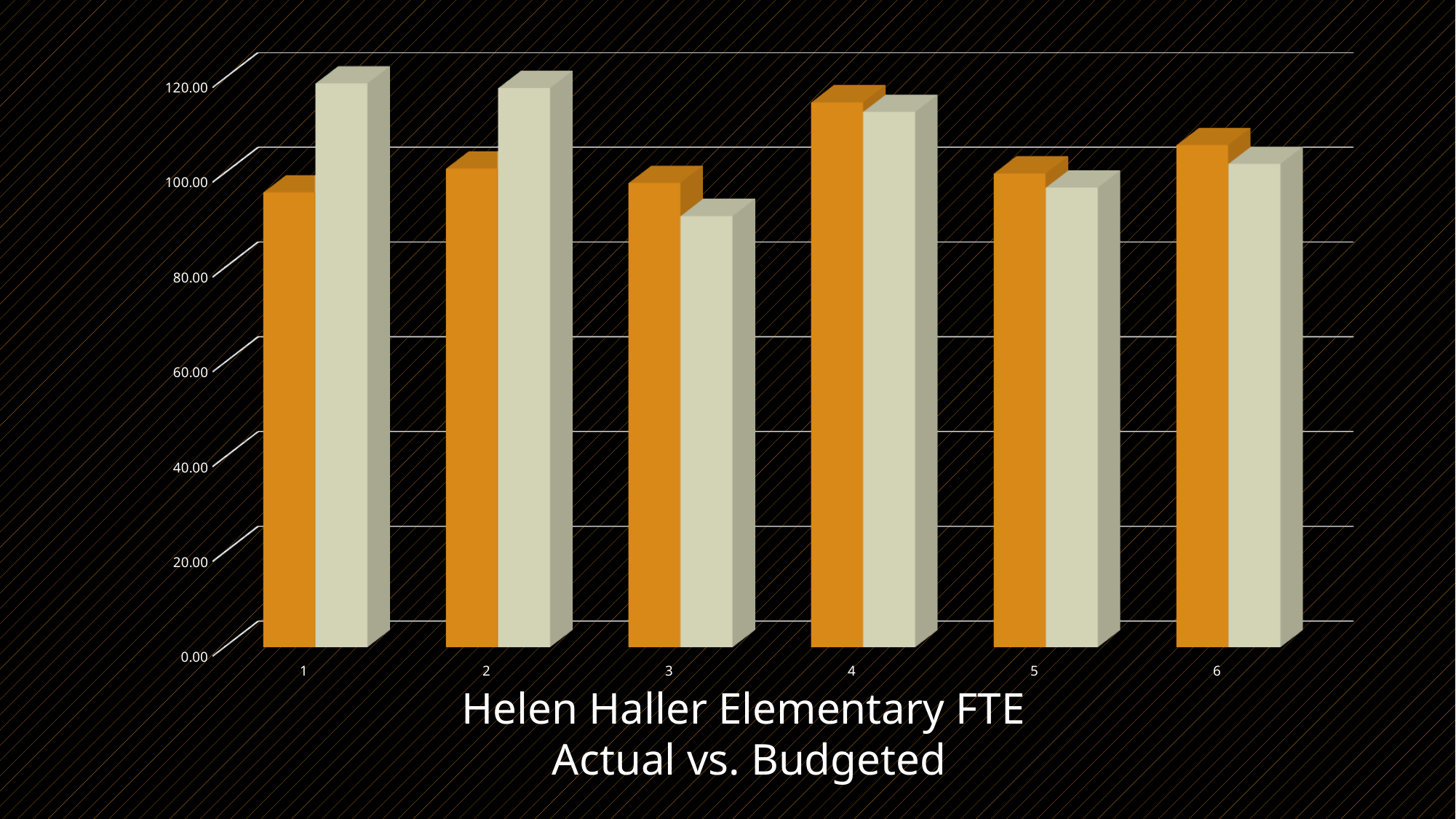
Which category has the lowest beige bar? 3 What two colours are used for the bars in the chart? orange and beige How many categories are shown along the x axis? 6 Is the value of the orange bar for category 1 greater or less than 100.00? less Is the value of the beige bar for category 3 greater or less than 80.00? greater For category 1, which bar is taller, the orange bar or the beige bar? beige bar How many bars are plotted for each category? 2 Is the value of the beige bar for category 1 greater or less than 100.00? greater What is the title of the chart? Helen Haller Elementary FTE Actual vs. Budgeted What kind of chart is shown on the slide? bar chart For category 3, which bar is taller, the orange bar or the beige bar? orange bar